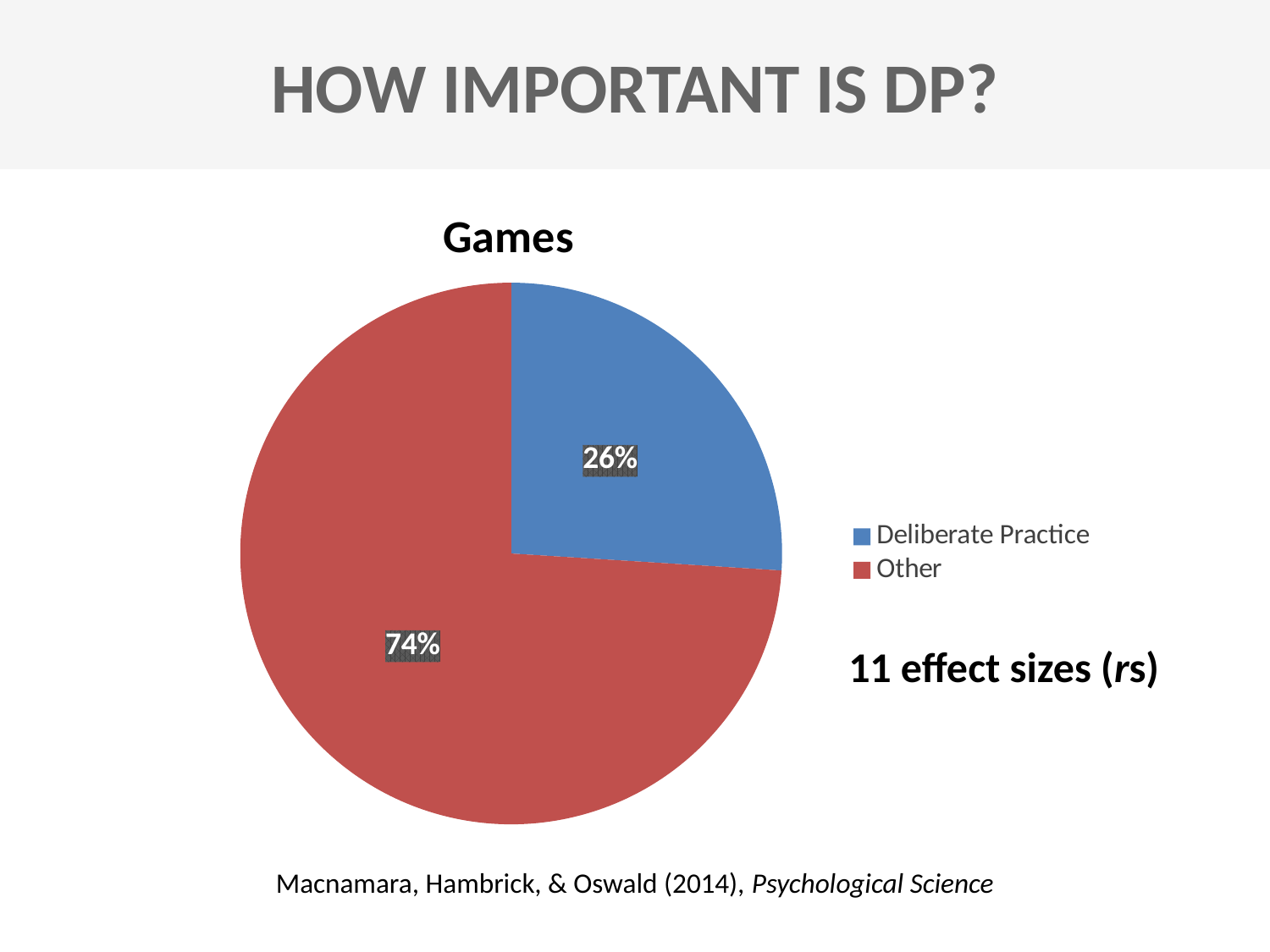
Which slice is the smallest? Deliberate Practice How many entries does the legend list? 2 What share of the pie does Other take? 74% Which is larger, the Deliberate Practice slice or the Other slice? Other What share of the pie does Deliberate Practice take? 26% How many slices does the pie chart have? 2 What is the chart's title? Games What kind of chart is shown on the slide? pie chart What is the difference in percentage points between the Other slice and the Deliberate Practice slice? 48 Is the share for Deliberate Practice greater or less than 50%? less Which slice is the largest? Other What colour is the Deliberate Practice slice? blue